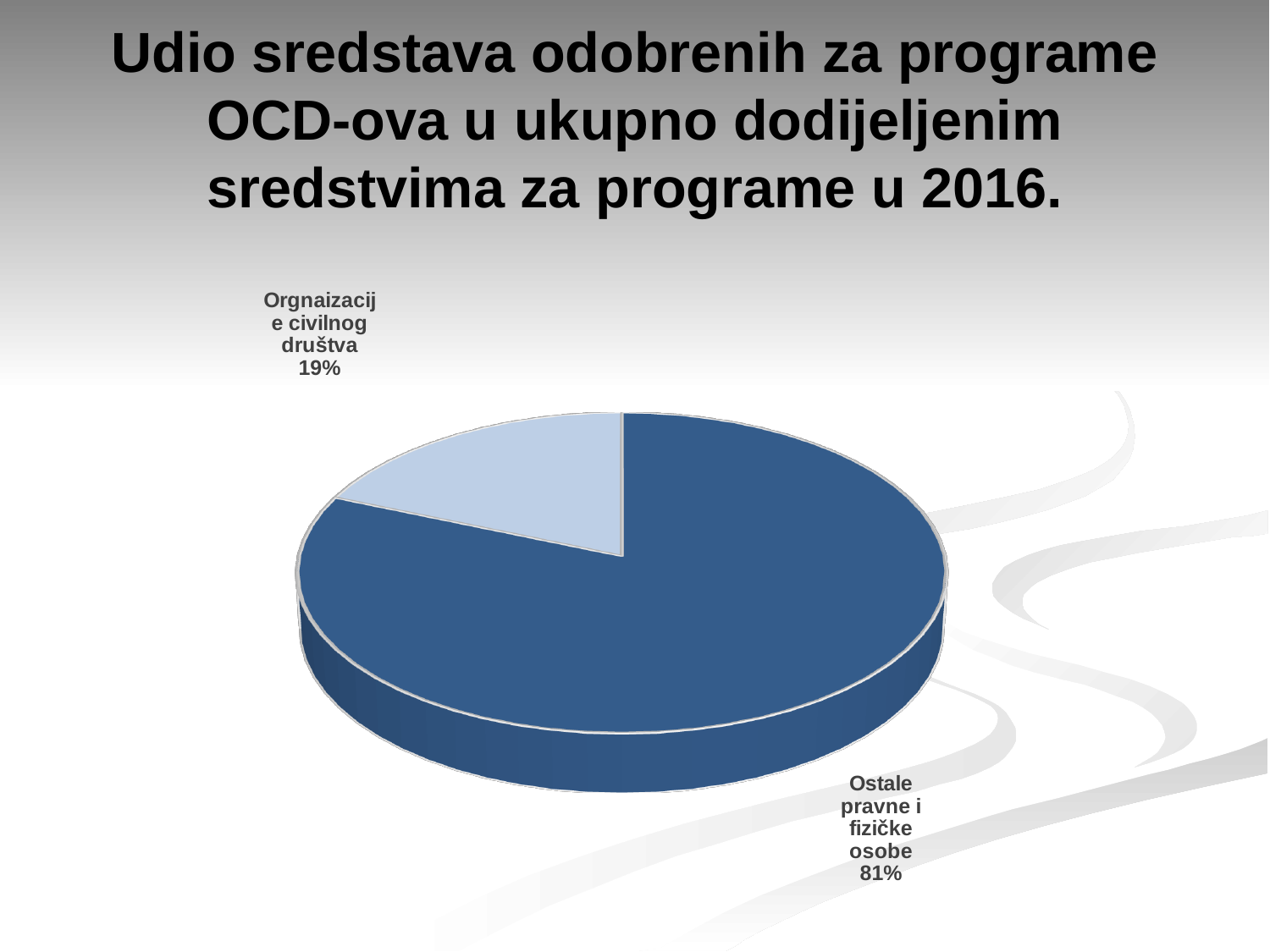
Which slice of the pie is the largest? Ostale pravne i fizičke osobe What share of the pie does "Orgnaizacije civilnog društva" hold? 19% What is the difference in percentage points between the "Ostale pravne i fizičke osobe" slice and the "Orgnaizacije civilnog društva" slice? 62 Which is larger: the share for "Orgnaizacije civilnog društva" or the share for "Ostale pravne i fizičke osobe"? Ostale pravne i fizičke osobe Which slice of the pie is shown in the lighter blue colour? Orgnaizacije civilnog društva What share of the pie does "Ostale pravne i fizičke osobe" hold? 81% How many slices does the pie chart have? 2 What is the title of the chart on the slide? Udio sredstava odobrenih za programe OCD-ova u ukupno dodijeljenim sredstvima za programe u 2016. What kind of chart is shown on the slide? pie chart Which slice of the pie is the smallest? Orgnaizacije civilnog društva